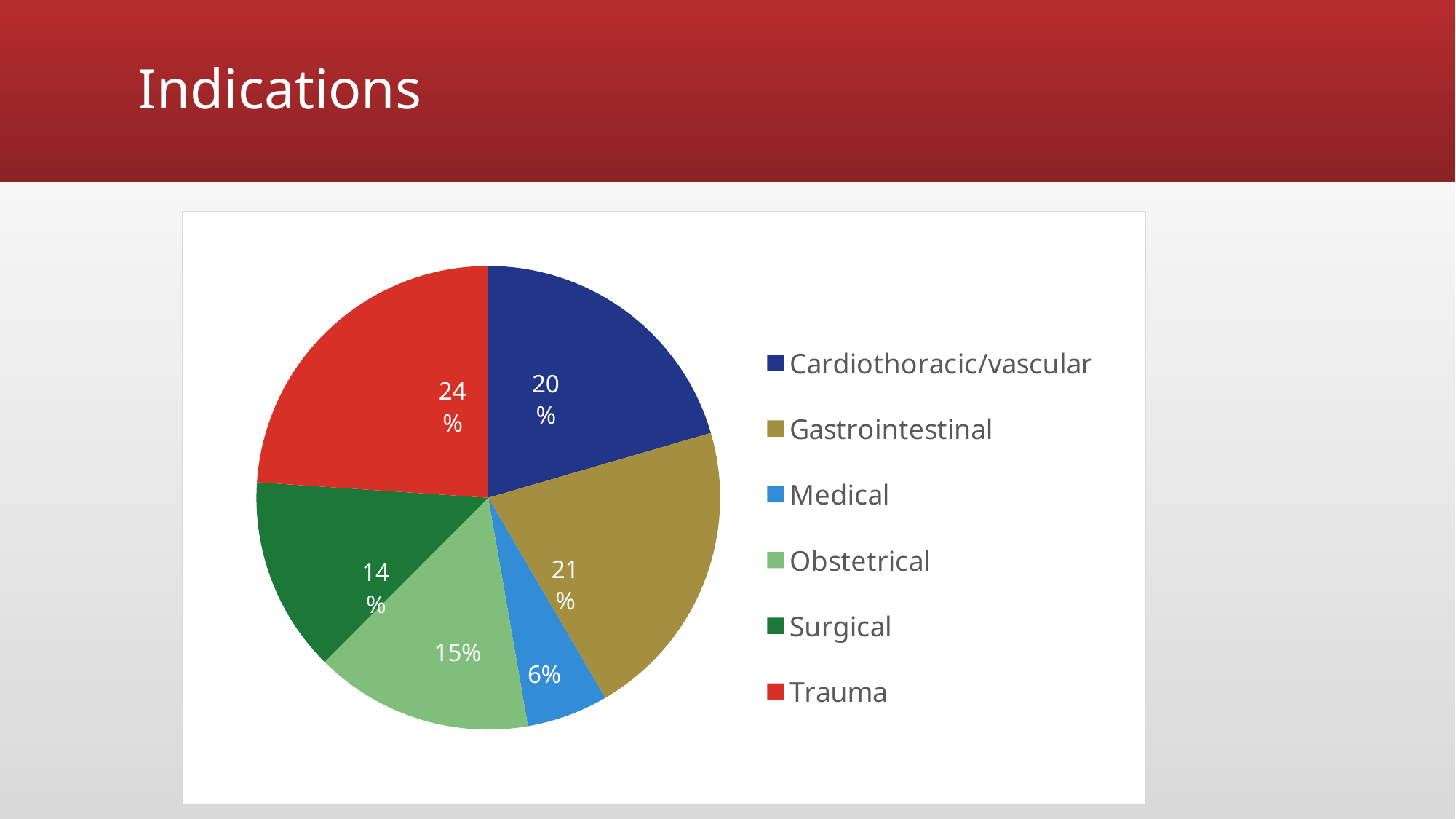
What colour is the Surgical slice in the pie chart? dark green What is the difference between the Trauma and Medical percentages? 18% Which category has the largest slice of the pie? Trauma What is the value shown for Surgical? 14% What is the value shown for Gastrointestinal? 21% What is the value shown for Medical? 6% Which category has the smallest slice of the pie? Medical What is the value shown for Obstetrical? 15% What kind of chart is shown on the slide? pie chart What share of the pie does Trauma account for? 24% Which is larger, the Cardiothoracic/vascular slice or the Obstetrical slice? Cardiothoracic/vascular How many categories does the pie chart show? 6